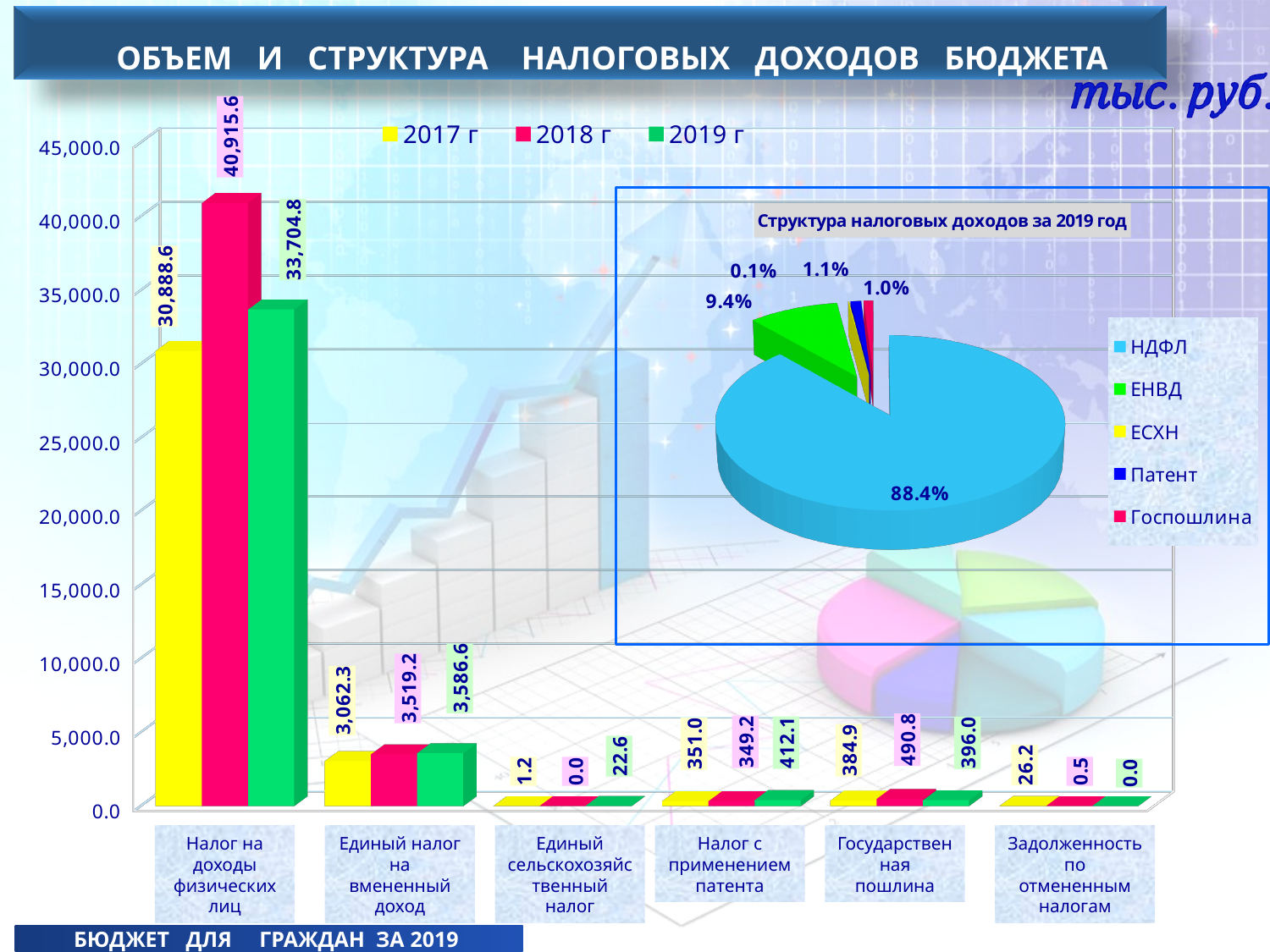
In the bar chart, what is the difference between the 2018 and 2017 values for Налог на доходы физических лиц? 10,027.0 In the bar chart, which year has the highest value for Налог на доходы физических лиц? 2018 г In the pie chart 'Структура налоговых доходов за 2019 год', what share does ЕНВД have? 9.4% In the bar chart, what is the 2019 value for Налог с применением патента? 412.1 In the pie chart 'Структура налоговых доходов за 2019 год', what share does НДФЛ have? 88.4% How many categories are shown on the x axis of the bar chart? 6 In the bar chart, which year has the lowest value for Задолженность по отмененным налогам? 2019 г How many series does the bar chart legend list? 3 In the bar chart, what is the 2019 value for Единый налог на вмененный доход? 3,586.6 In the bar chart, which is larger for Государственная пошлина: the 2018 value or the 2019 value? 2018 г In the bar chart, what is the 2018 value for Налог на доходы физических лиц? 40,915.6 In the bar chart, what is the 2017 value for Государственная пошлина? 384.9